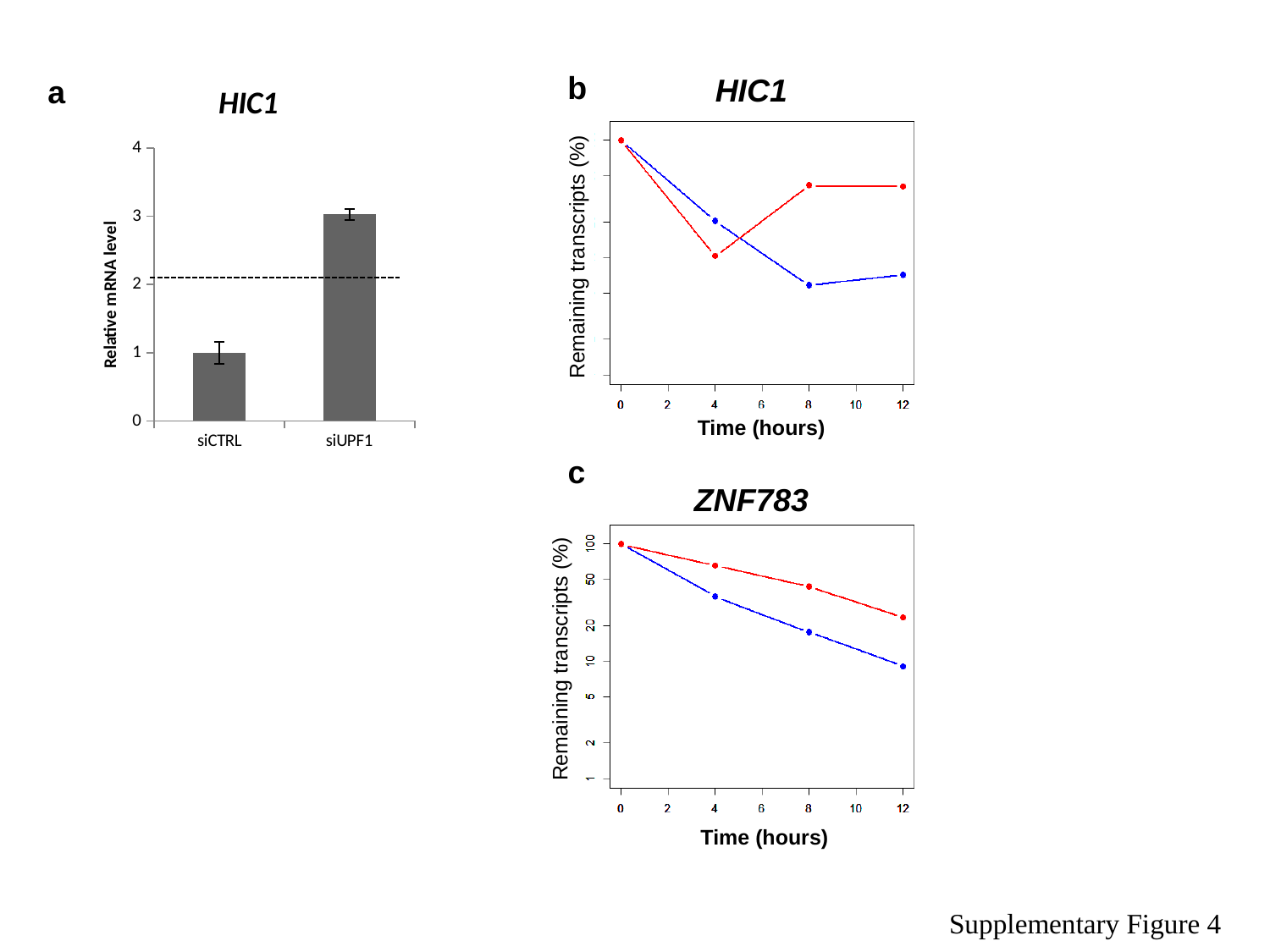
What kind of chart is chart a (HIC1, top left)? bar chart What kind of chart is chart b (HIC1, top right)? line chart In chart a (HIC1 bar chart), is the value for siUPF1 greater or less than 2? greater What is the y-axis label of chart a (HIC1 bar chart)? Relative mRNA level In chart b (HIC1 line chart), how many time points are plotted on each line? 4 In chart c (ZNF783), do the remaining transcripts rise or fall as time increases? fall In chart a (HIC1 bar chart), which category has the higher relative mRNA level? siUPF1 What is the x-axis label of chart c (ZNF783)? Time (hours) In chart a (HIC1 bar chart), is the value for siCTRL greater or less than 2? less In chart a (HIC1 bar chart), how many categories are shown on the x axis? 2 In chart c (ZNF783), at 12 hours, which line has the higher value, the red line or the blue line? red line